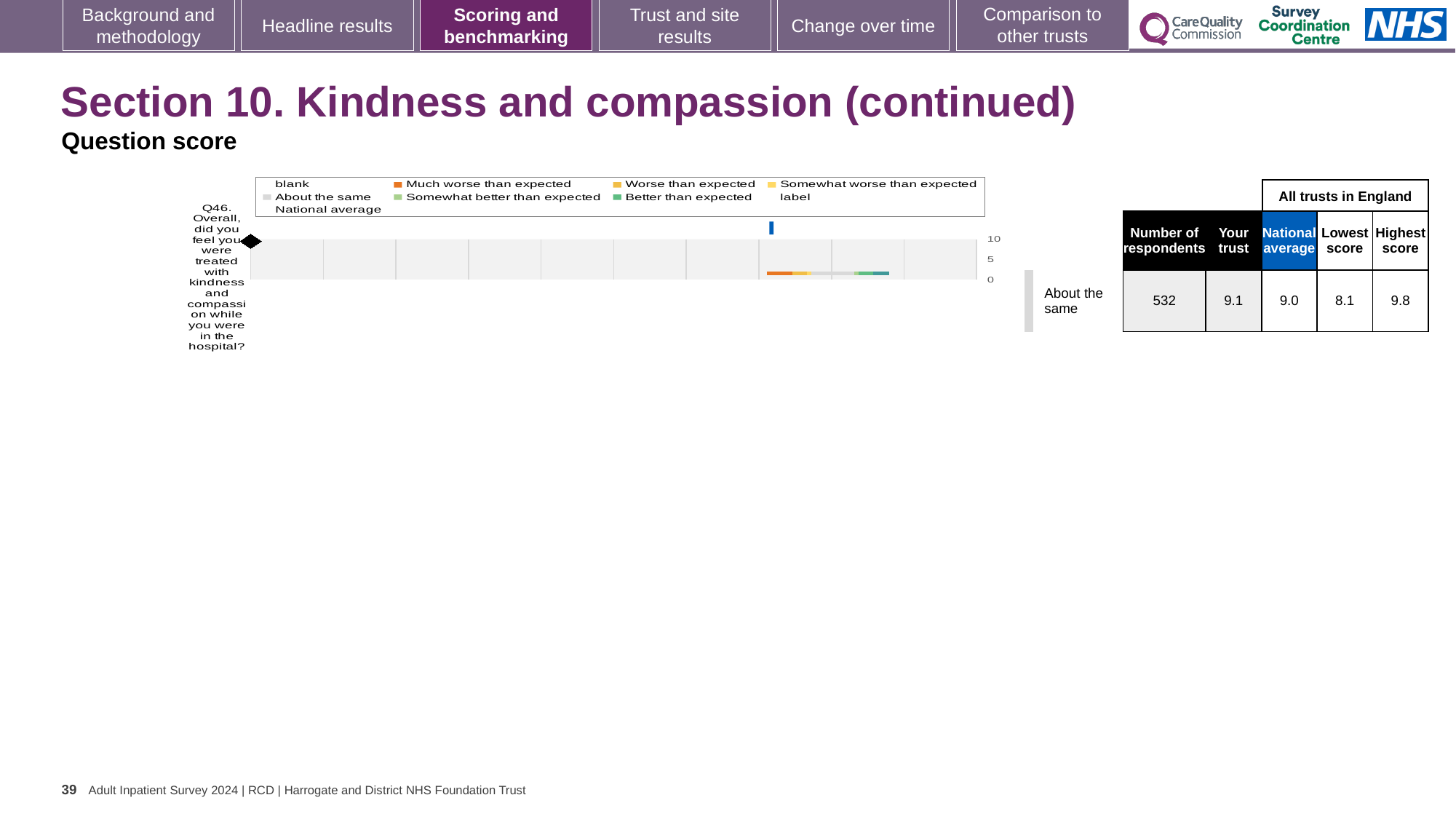
Which benchmarking category is the trust's Q46 result placed in? About the same What is the lowest score among all trusts in England for Q46? 8.1 What colour represents 'Much worse than expected' in the chart legend? orange How many respondents answered Q46? 532 What is the difference between the 'Your trust' score and the national average for Q46? 0.1 What is the national average score for Q46 shown on the slide? 9.0 Which is larger for Q46, the 'Your trust' score or the national average? Your trust What is the difference between the highest score and the lowest score for Q46? 1.7 Is the 'Your trust' score for Q46 greater or less than 5 on the chart axis? greater What is the highest score among all trusts in England for Q46? 9.8 What is the 'Your trust' score for Q46 shown on the slide? 9.1 What kind of chart is shown on the slide for Q46? bar chart